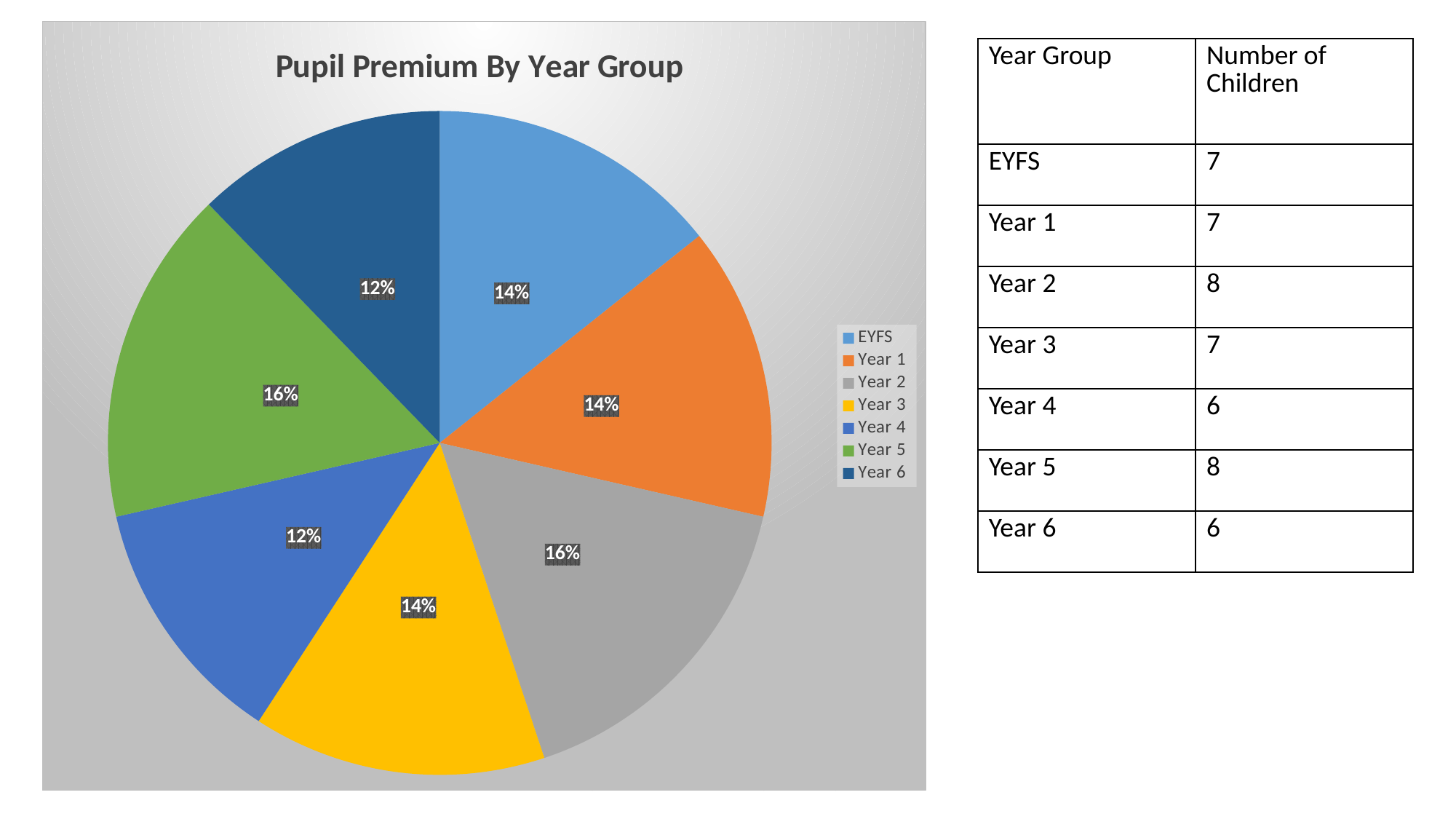
Which year groups have the largest share of the pie? Year 2 and Year 5 Which year groups have the smallest share of the pie? Year 4 and Year 6 What percentage share does the Year 4 slice show? 12% What is the title of the chart? Pupil Premium By Year Group How many slices does the pie chart have? 7 What percentage share does the Year 6 slice show? 12% Which legend entry is shown in yellow? Year 3 What percentage share does the EYFS slice show? 14% What type of chart is shown on the slide? pie chart Which slice is larger, Year 2 or Year 6? Year 2 What is the difference in percentage points between the Year 5 slice and the Year 4 slice? 4